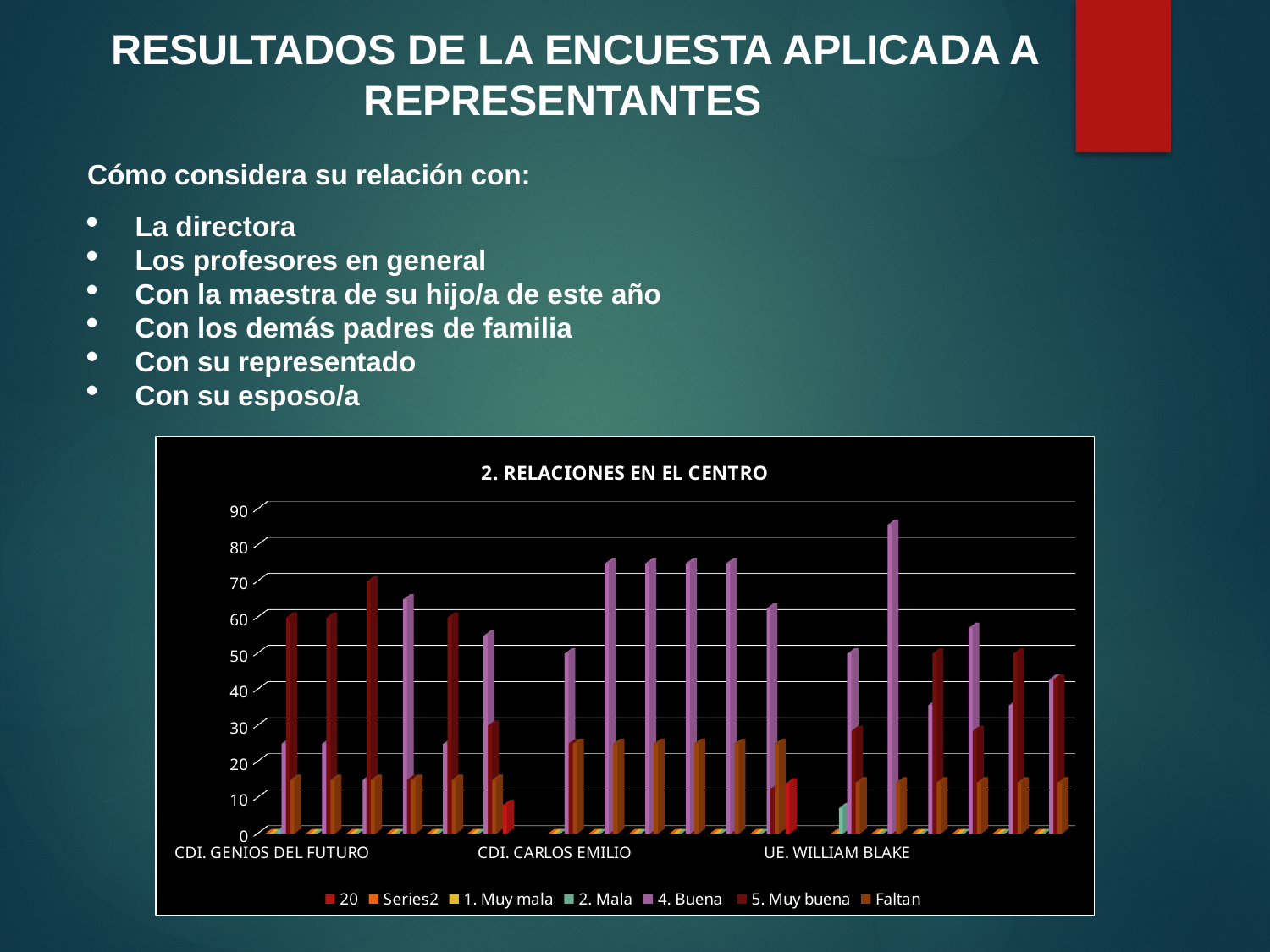
Which series has the tallest bar in the chart? 4. Buena Is the tallest bar in the chart greater or less than 80? greater What is the highest value shown on the y axis of the chart? 90 Which x-axis category contains the tallest bar in the chart? UE. WILLIAM BLAKE What kind of chart is shown on the slide? bar chart How many category labels are shown on the x axis of the chart? 3 How many series does the chart legend list? 7 What is the title of the chart? 2. RELACIONES EN EL CENTRO